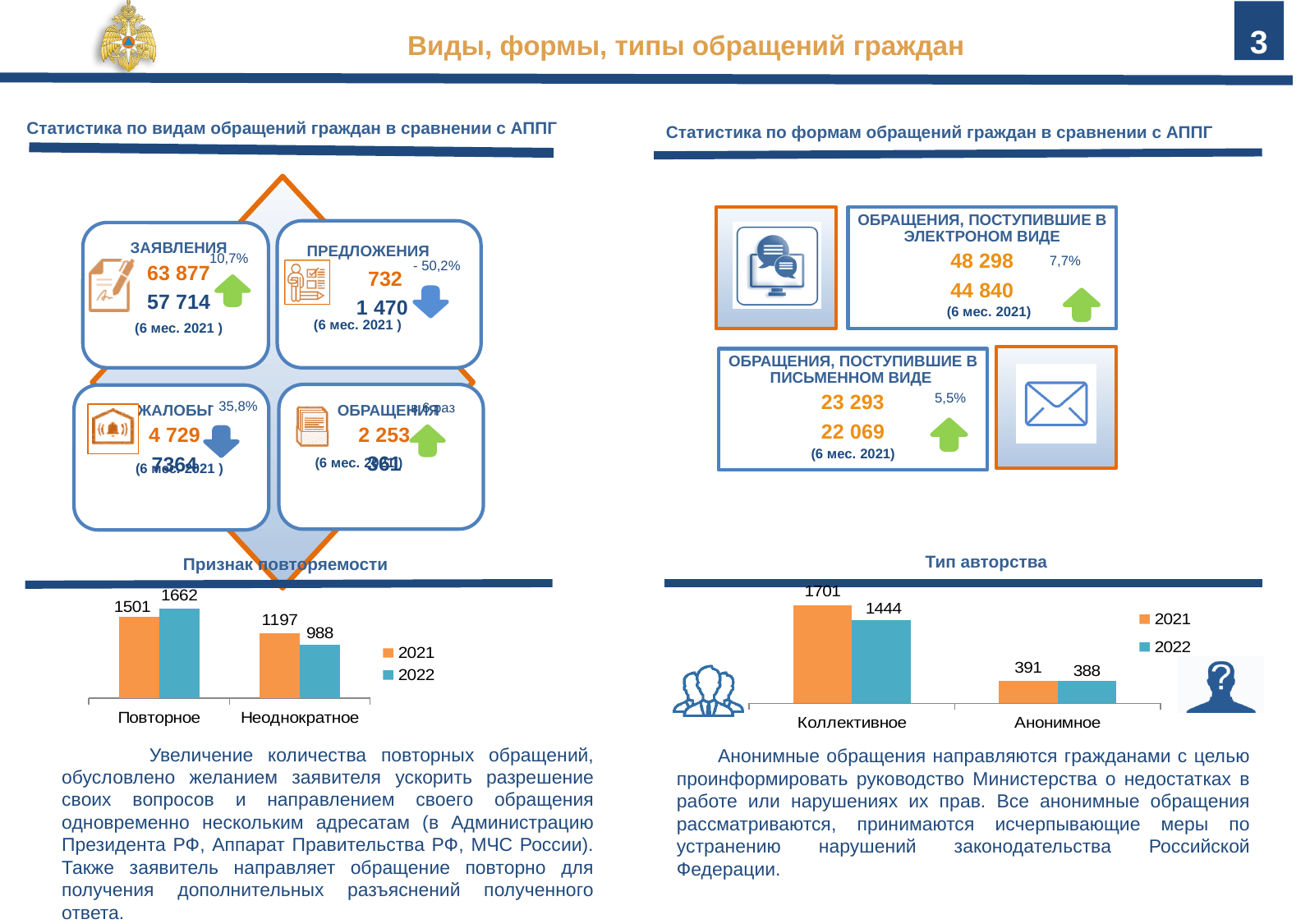
In the 'Признак повторяемости' chart, how many series does the legend list? 2 In the 'Признак повторяемости' chart, which is larger for Неоднократное: the 2021 value or the 2022 value? 2021 In the 'Тип авторства' chart, what is the 2021 value for Коллективное? 1701 In the 'Признак повторяемости' chart, what is the 2021 value for Неоднократное? 1197 In the 'Тип авторства' chart, what is the 2022 value for Анонимное? 388 In the 'Признак повторяемости' chart, what is the 2022 value for Повторное? 1662 What kind of chart is the 'Тип авторства' chart? Bar chart In the 'Тип авторства' chart, what is the difference between the 2021 and 2022 values for Коллективное? 257 In the 'Тип авторства' chart, which colour represents the 2021 series? Orange In the 'Признак повторяемости' chart, how many categories are shown on the x axis? 2 In the 'Признак повторяемости' chart, what is the difference between the 2021 and 2022 values for Повторное? 161 In the 'Тип авторства' chart, which category has the lowest 2022 value? Анонимное